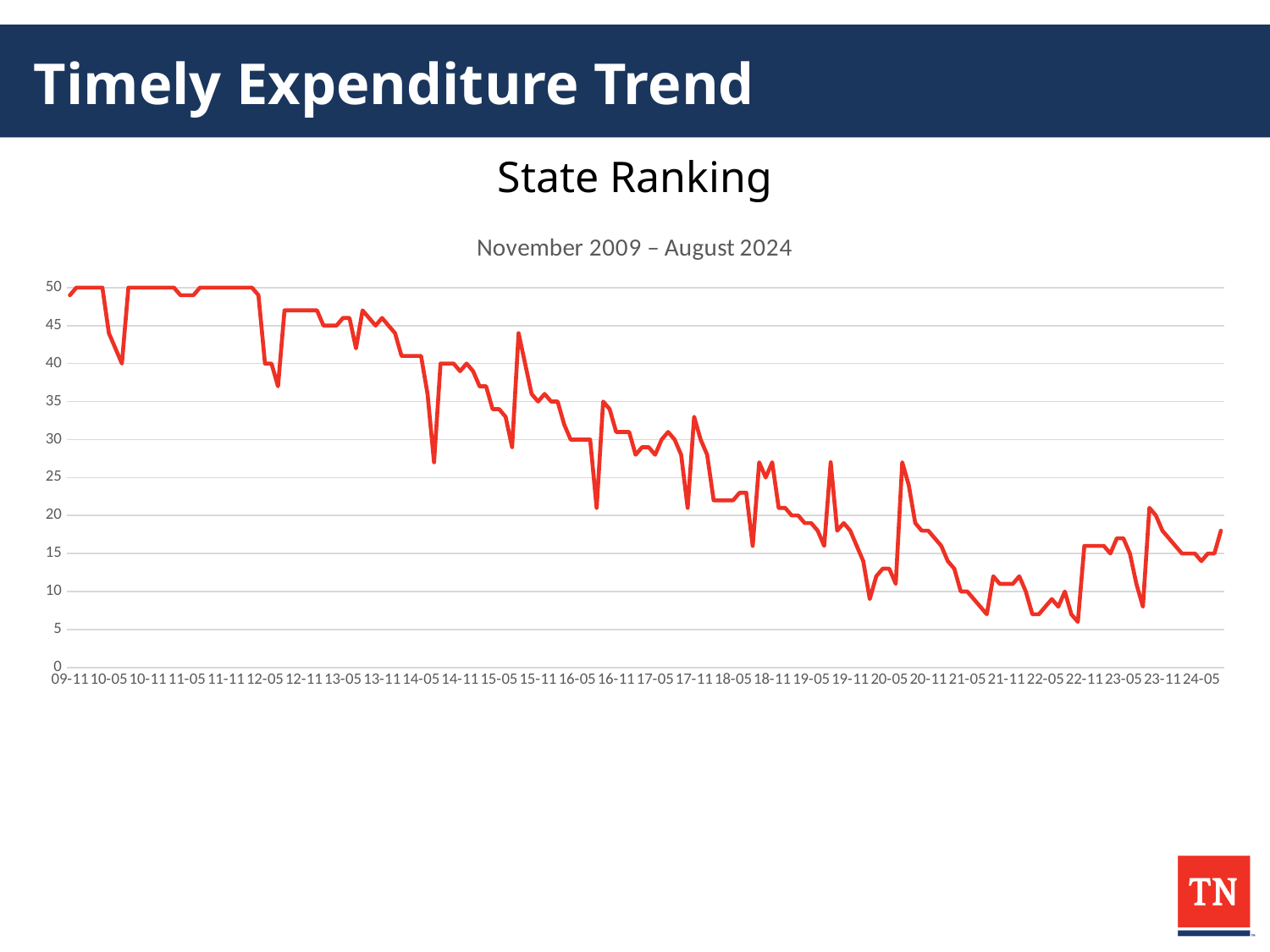
Overall, do the state ranking values rise or fall from left to right along the x axis? fall Is the value at 16-05 greater or less than 25? greater What is the maximum value shown on the y axis? 50 What is the highest value the line reaches on the chart? 50 Which is larger, the value at 11-05 or the value at 20-05? 11-05 Is the value at 22-05 greater or less than 15? less Is the value at 21-11 greater or less than 20? less What date range is shown as the chart's title? November 2009 – August 2024 What kind of chart is shown on the slide? line chart